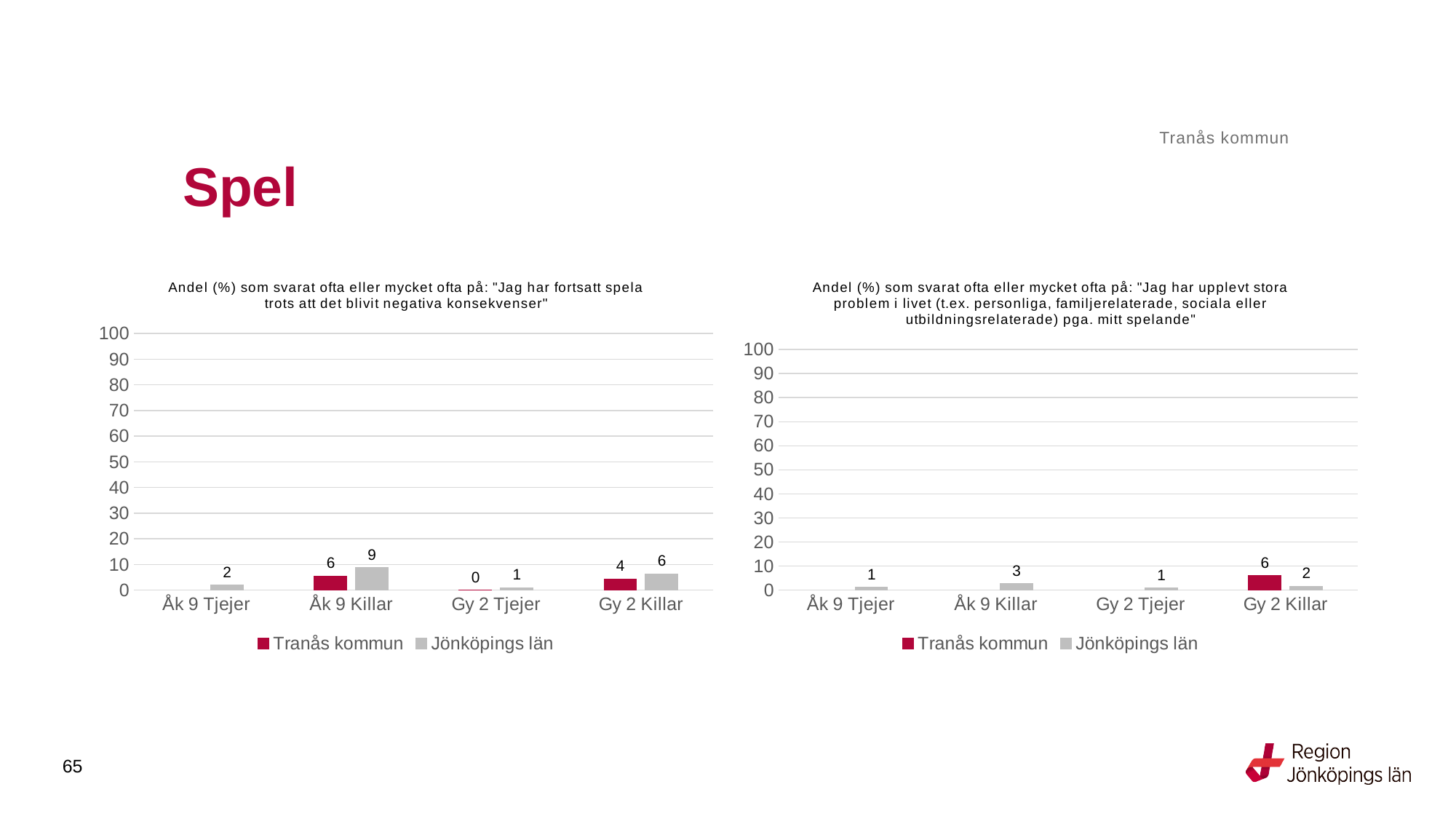
In the right chart ("Jag har upplevt stora problem i livet ... pga. mitt spelande"), what is the value for Jönköpings län for Åk 9 Killar? 3 In the left chart ("Jag har fortsatt spela trots att det blivit negativa konsekvenser"), what is the value for Tranås kommun for Gy 2 Tjejer? 0 In the left chart ("Jag har fortsatt spela trots att det blivit negativa konsekvenser"), what is the value for Jönköpings län for Åk 9 Killar? 9 In the left chart ("Jag har fortsatt spela trots att det blivit negativa konsekvenser"), what is the value for Tranås kommun for Gy 2 Killar? 4 In the right chart ("Jag har upplevt stora problem i livet ... pga. mitt spelande"), what is the value for Tranås kommun for Gy 2 Killar? 6 How many series does the legend of the left chart list? 2 In the right chart ("Jag har upplevt stora problem i livet ... pga. mitt spelande"), what is the difference between Tranås kommun and Jönköpings län for Gy 2 Killar? 4 What kind of chart is the right chart? Bar chart In the left chart ("Jag har fortsatt spela trots att det blivit negativa konsekvenser"), what is the difference between Jönköpings län and Tranås kommun for Åk 9 Killar? 3 In the left chart ("Jag har fortsatt spela trots att det blivit negativa konsekvenser"), which is larger for Gy 2 Killar: Tranås kommun or Jönköpings län? Jönköpings län In the left chart ("Jag har fortsatt spela trots att det blivit negativa konsekvenser"), which category has the highest value for Jönköpings län? Åk 9 Killar In the right chart ("Jag har upplevt stora problem i livet ... pga. mitt spelande"), which is larger for Gy 2 Killar: Tranås kommun or Jönköpings län? Tranås kommun